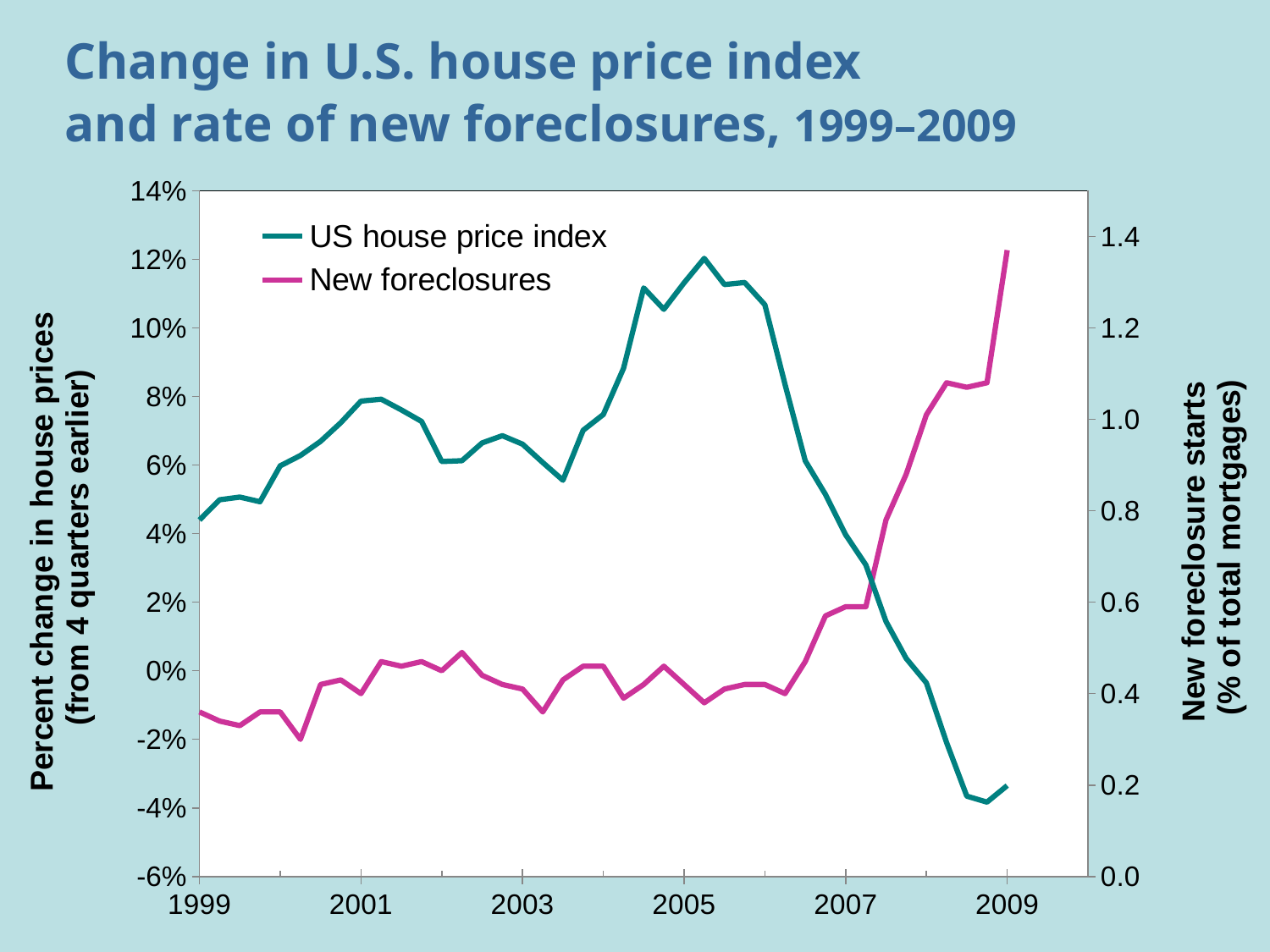
Is the value of the US house price index in 2005 greater or less than 10%? greater Does the US house price index line rise or fall between 2005 and 2009? fall What are the two series named in the legend? US house price index; New foreclosures What kind of chart is shown on the slide? line chart Is the value for New foreclosures in 2009 greater or less than 1.2? greater Does the New foreclosures line rise or fall between 2007 and 2009? rise Which is larger for the US house price index: the value in 2005 or the value in 2009? 2005 In which labeled year does the New foreclosures series reach its highest value? 2009 How many series does the legend list? 2 Is the value for New foreclosures in 2007 greater or less than 0.8? less What is the label of the right-hand vertical axis? New foreclosure starts (% of total mortgages)